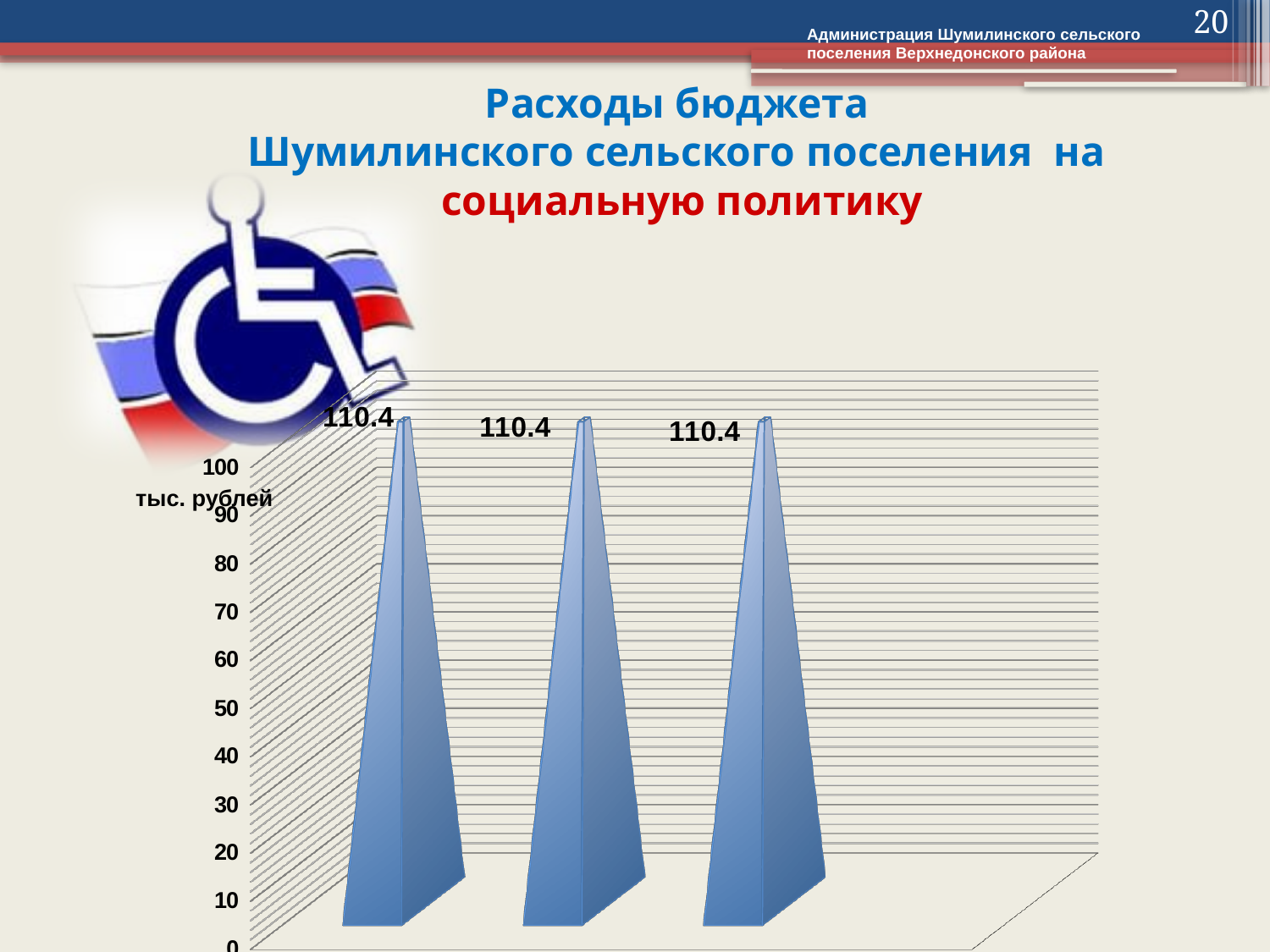
What is the value shown on the leftmost bar? 110.4 How many bars are plotted in the chart? 3 Do the values rise, fall, or stay the same from left to right across the bars? stay the same Is the value of the leftmost bar greater or less than 100? greater What is the highest tick value printed on the vertical axis? 100 What is the difference between the values of the leftmost and rightmost bars? 0 Is the middle bar larger, smaller, or equal to the rightmost bar? equal What unit is shown on the vertical axis of the chart? тыс. рублей What is the value shown on the rightmost bar? 110.4 What is the value shown on the middle bar? 110.4 What kind of chart is shown on the slide? bar chart